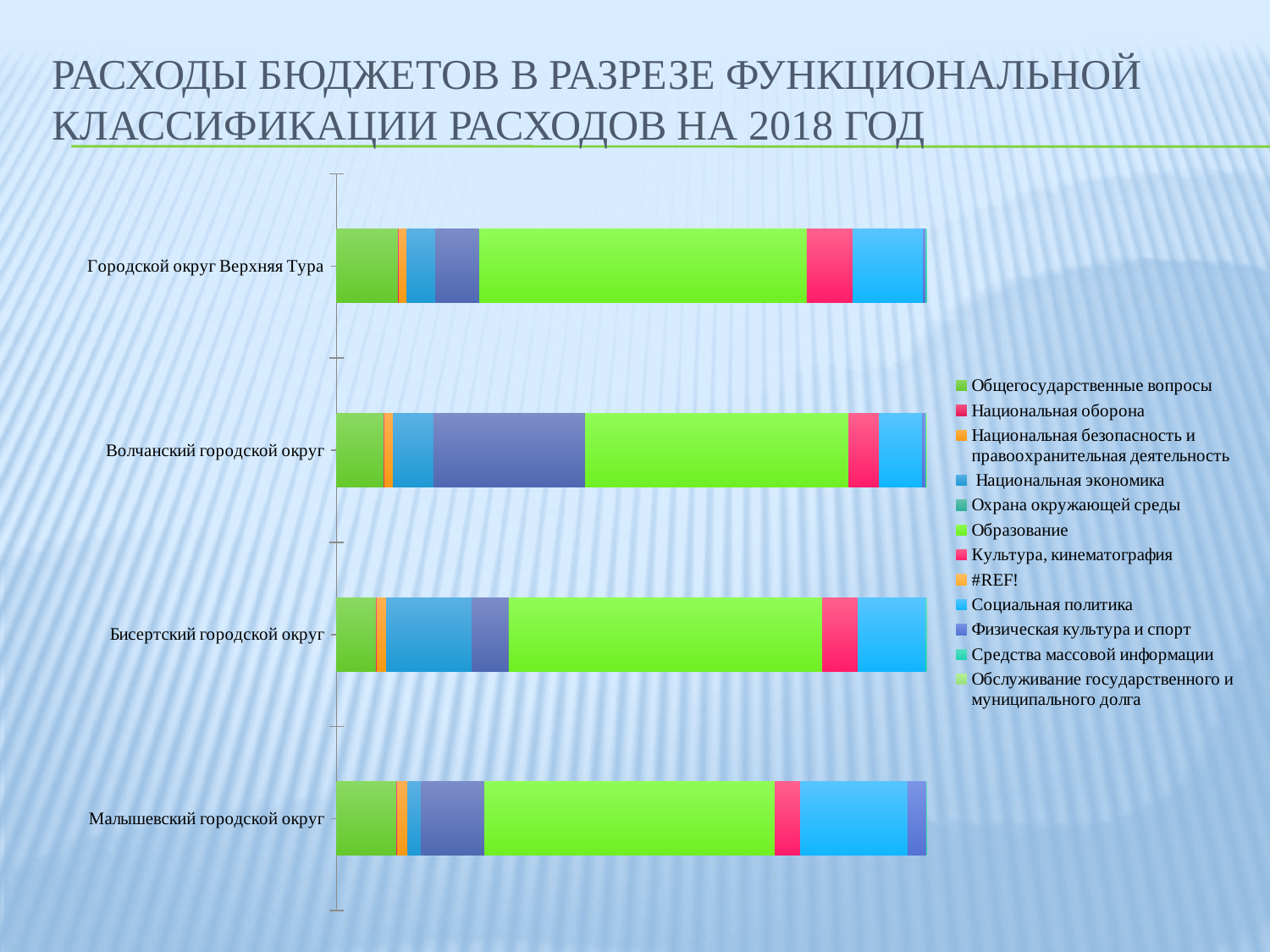
Which legend entry appears as an error reference rather than a category name? #REF! Which district has the largest segment for Национальная экономика? Бисертский городской округ Which district has the largest segment for Социальная политика? Малышевский городской округ Which district has the smallest segment for Социальная политика? Волчанский городской округ Which district has the smallest segment for Национальная экономика? Малышевский городской округ Is the Общегосударственные вопросы segment larger for Городской округ Верхняя Тура or for Бисертский городской округ? Городской округ Верхняя Тура How many municipal districts (categories) are shown on the chart? 4 Which category is shown at the top of the chart? Городской округ Верхняя Тура How many entries does the chart legend list? 12 What kind of chart is shown on the slide? Stacked bar chart Is the Образование segment larger for Городской округ Верхняя Тура or for Волчанский городской округ? Городской округ Верхняя Тура